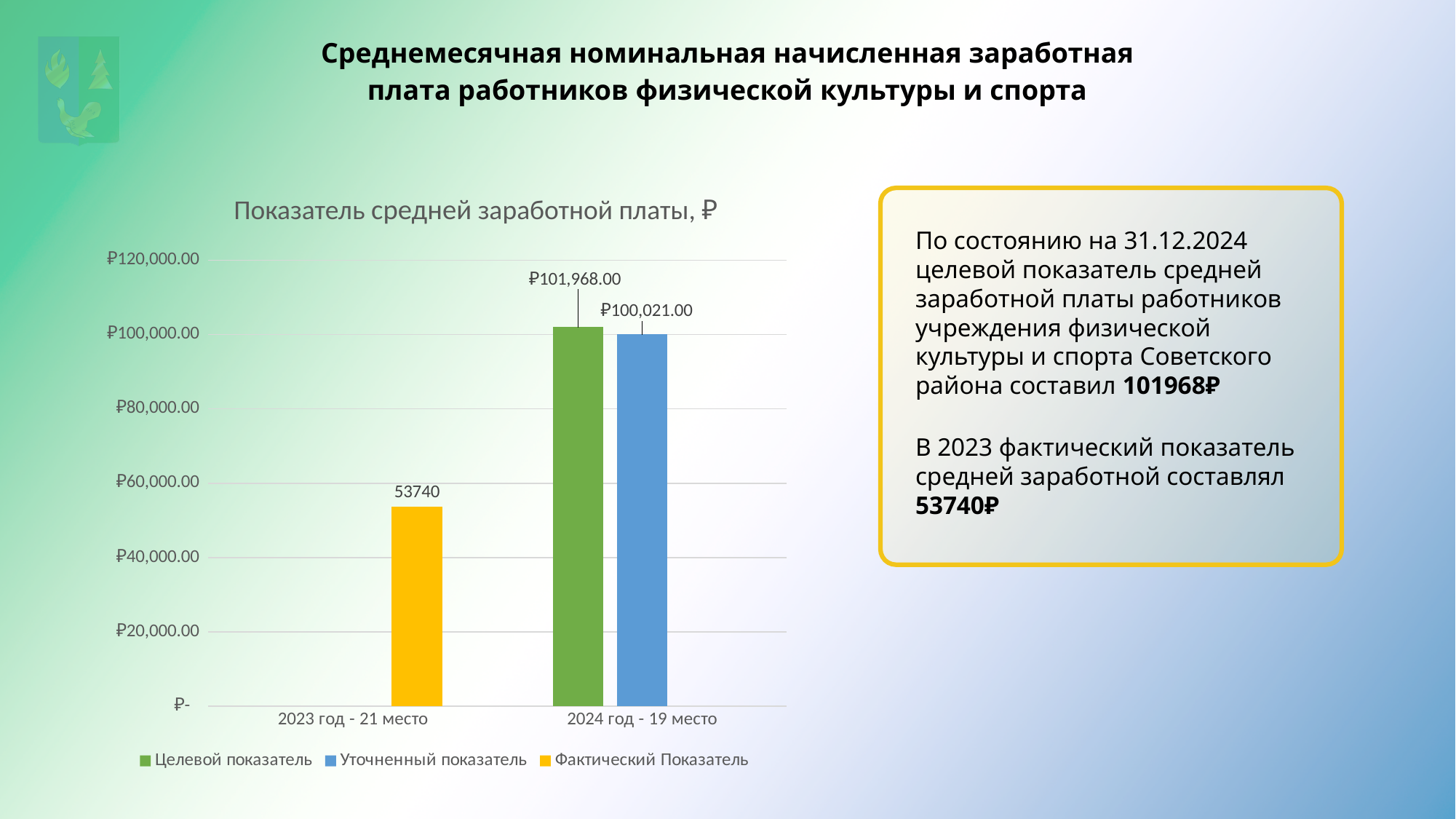
Which bar in the chart has the lowest value? Фактический Показатель for 2023 год - 21 место What is the value of the Уточненный показатель bar for 2024 год - 19 место? ₽100,021.00 What is the title of the chart? Показатель средней заработной платы, ₽ What is the value of the Фактический Показатель bar for 2023 год - 21 место? 53740 How many series does the chart legend list? 3 What type of chart is shown on the slide? bar chart What is the value of the Целевой показатель bar for 2024 год - 19 место? ₽101,968.00 Which bar in the chart has the highest value? Целевой показатель for 2024 год - 19 место How many categories are shown on the x axis of the chart? 2 Which legend entry is shown in yellow? Фактический Показатель Is the value of the Фактический Показатель bar for 2023 год - 21 место greater or less than ₽60,000.00? less What is the difference between the Целевой показатель and the Уточненный показатель for 2024 год - 19 место? ₽1,947.00